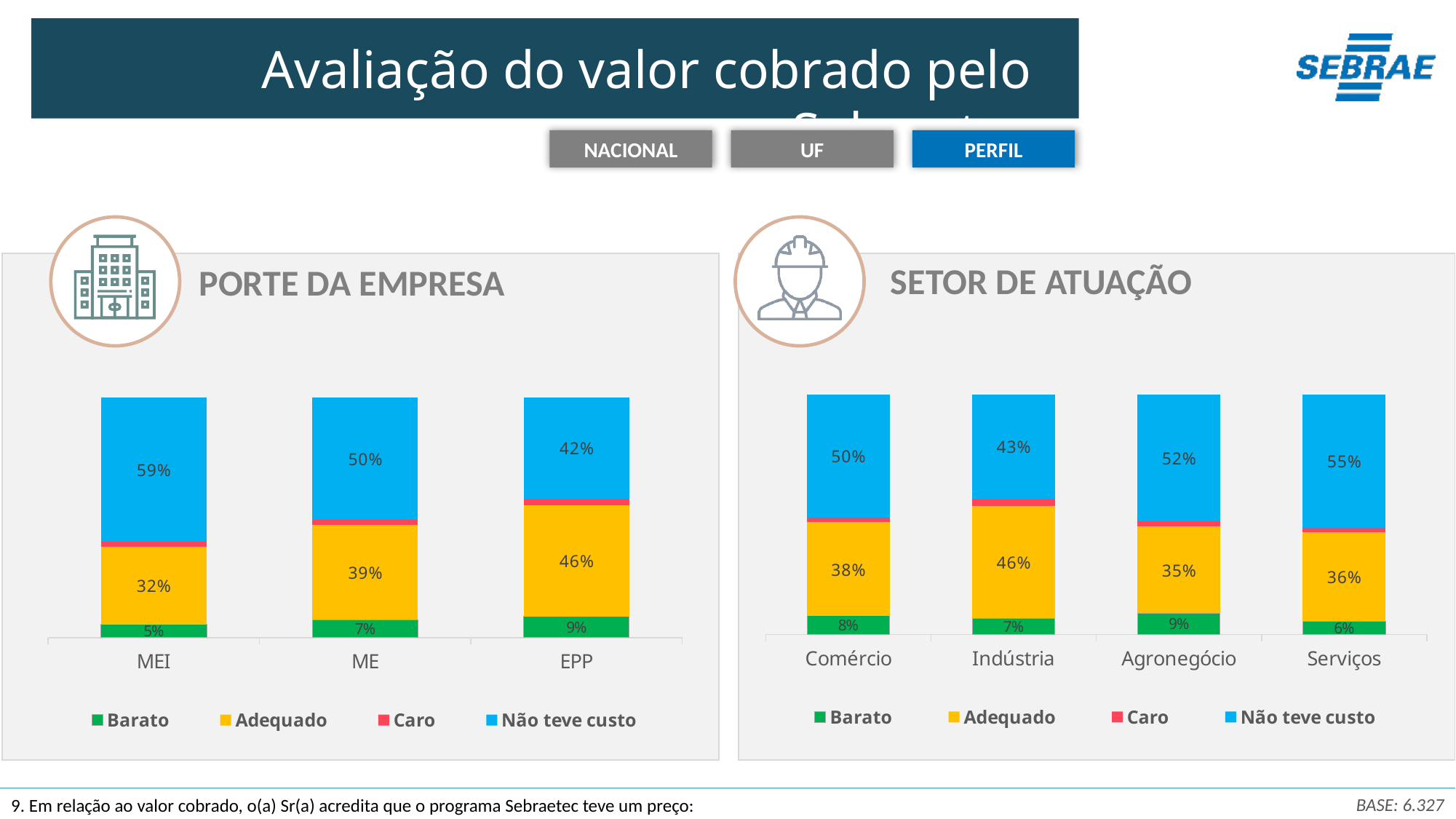
What kind of chart is the SETOR DE ATUAÇÃO chart? Stacked bar chart In the PORTE DA EMPRESA chart, which category has the highest 'Não teve custo' value? MEI In the SETOR DE ATUAÇÃO chart, which category has the lowest 'Adequado' value? Agronegócio In the SETOR DE ATUAÇÃO chart, what is the 'Barato' value for Agronegócio? 9% In the PORTE DA EMPRESA chart, what is the 'Adequado' value for EPP? 46% How many series does the legend of the PORTE DA EMPRESA chart list? 4 In the PORTE DA EMPRESA chart, which colour represents the 'Caro' series? Red How many categories are shown on the x axis of the SETOR DE ATUAÇÃO chart? 4 In the PORTE DA EMPRESA chart, what is the 'Não teve custo' value for MEI? 59% In the PORTE DA EMPRESA chart, what is the difference between the 'Adequado' values for EPP and MEI? 14 percentage points In the SETOR DE ATUAÇÃO chart, which is larger: the 'Não teve custo' value for Comércio or for Indústria? Comércio In the SETOR DE ATUAÇÃO chart, what is the 'Não teve custo' value for Serviços? 55%